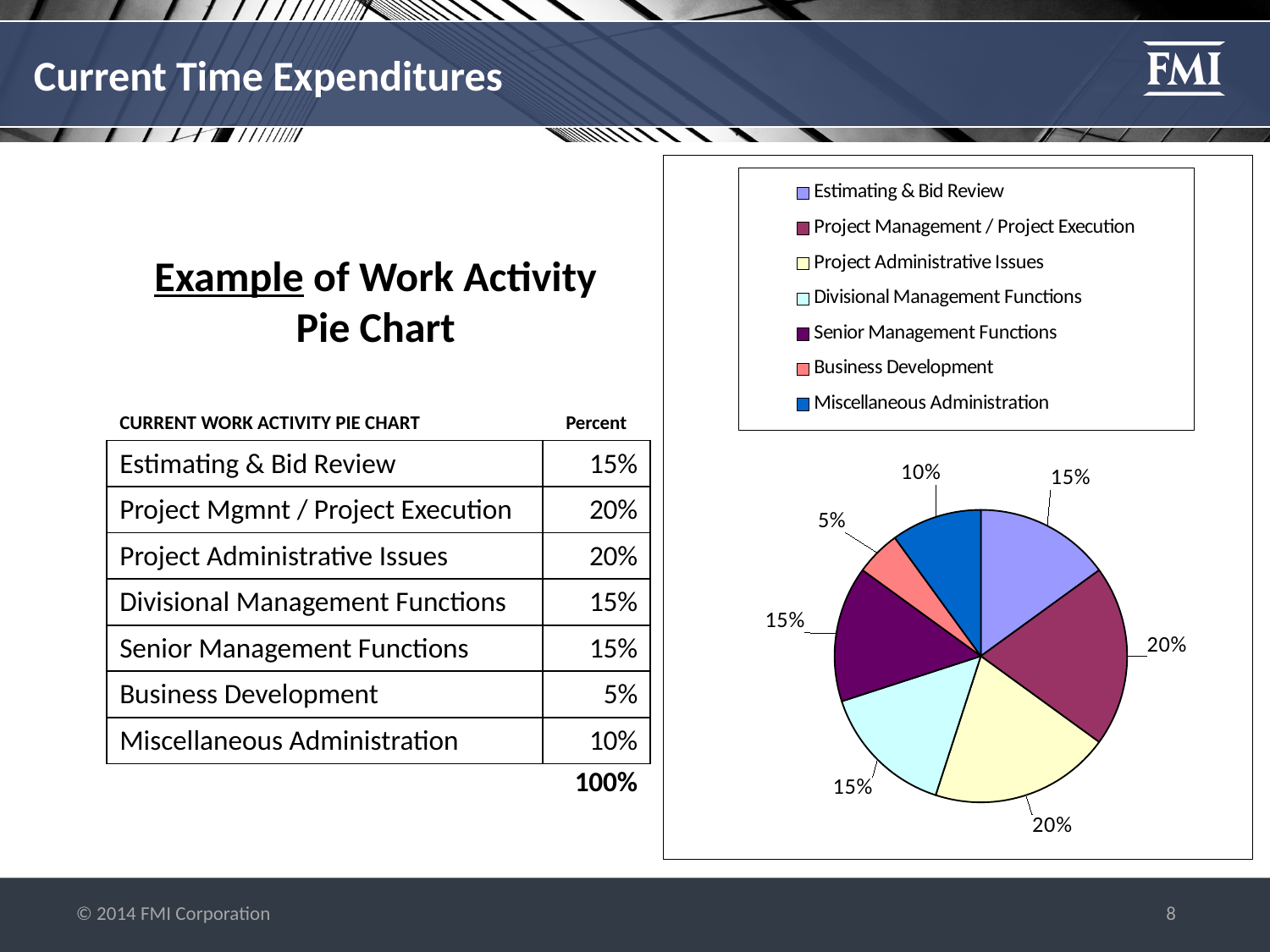
Which category has the smallest slice in the pie chart? Business Development How many slices does the pie chart have? 7 Which legend entry is listed first in the pie chart's legend? Estimating & Bid Review Which slice is larger in the pie chart: Miscellaneous Administration or Business Development? Miscellaneous Administration What share of the pie does Senior Management Functions represent? 15% How many entries does the pie chart's legend list? 7 What kind of chart is shown on the slide? pie chart What is the difference in percentage points between Project Management / Project Execution and Business Development in the pie chart? 15 What percentage does the pie chart show for Project Administrative Issues? 20% What percentage does the pie chart show for Estimating & Bid Review? 15% What percentage does the pie chart show for Miscellaneous Administration? 10% What percentage does the pie chart show for Business Development? 5%